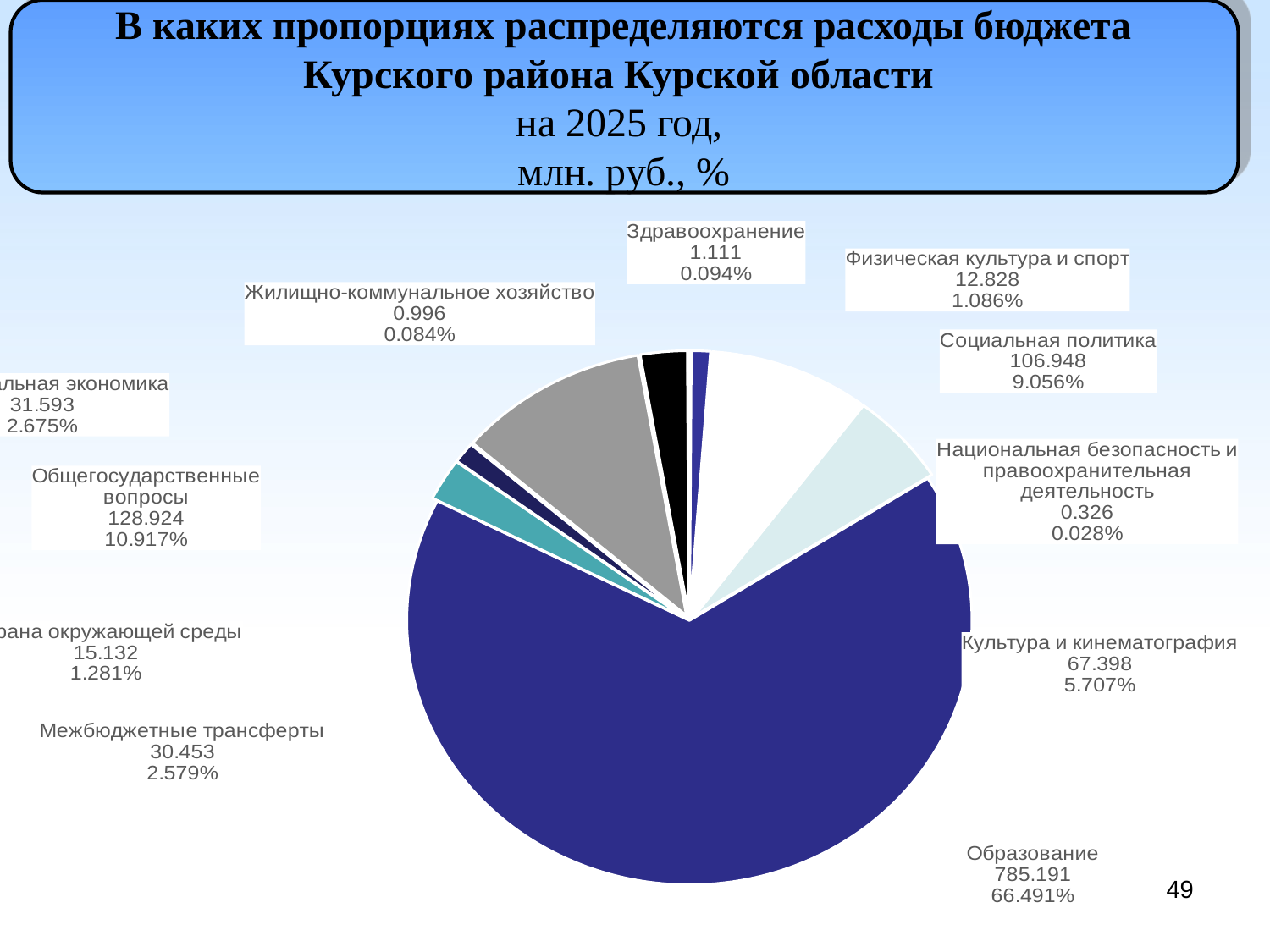
How many categories are shown in the pie chart? 11 What kind of chart is shown on the slide? pie chart Which is larger, Физическая культура и спорт or Межбюджетные трансферты? Межбюджетные трансферты What is the value for Социальная политика? 106.948 What is the value for Образование? 785.191 What is the value for Культура и кинематография? 67.398 What percentage is shown for Общегосударственные вопросы? 10.917% What share of the pie does Образование represent? 66.491% What is the difference between the values for Общегосударственные вопросы and Социальная политика? 21.976 Which category has the smallest value? Национальная безопасность и правоохранительная деятельность What percentage is shown for Здравоохранение? 0.094% Which category has the largest slice of the pie? Образование